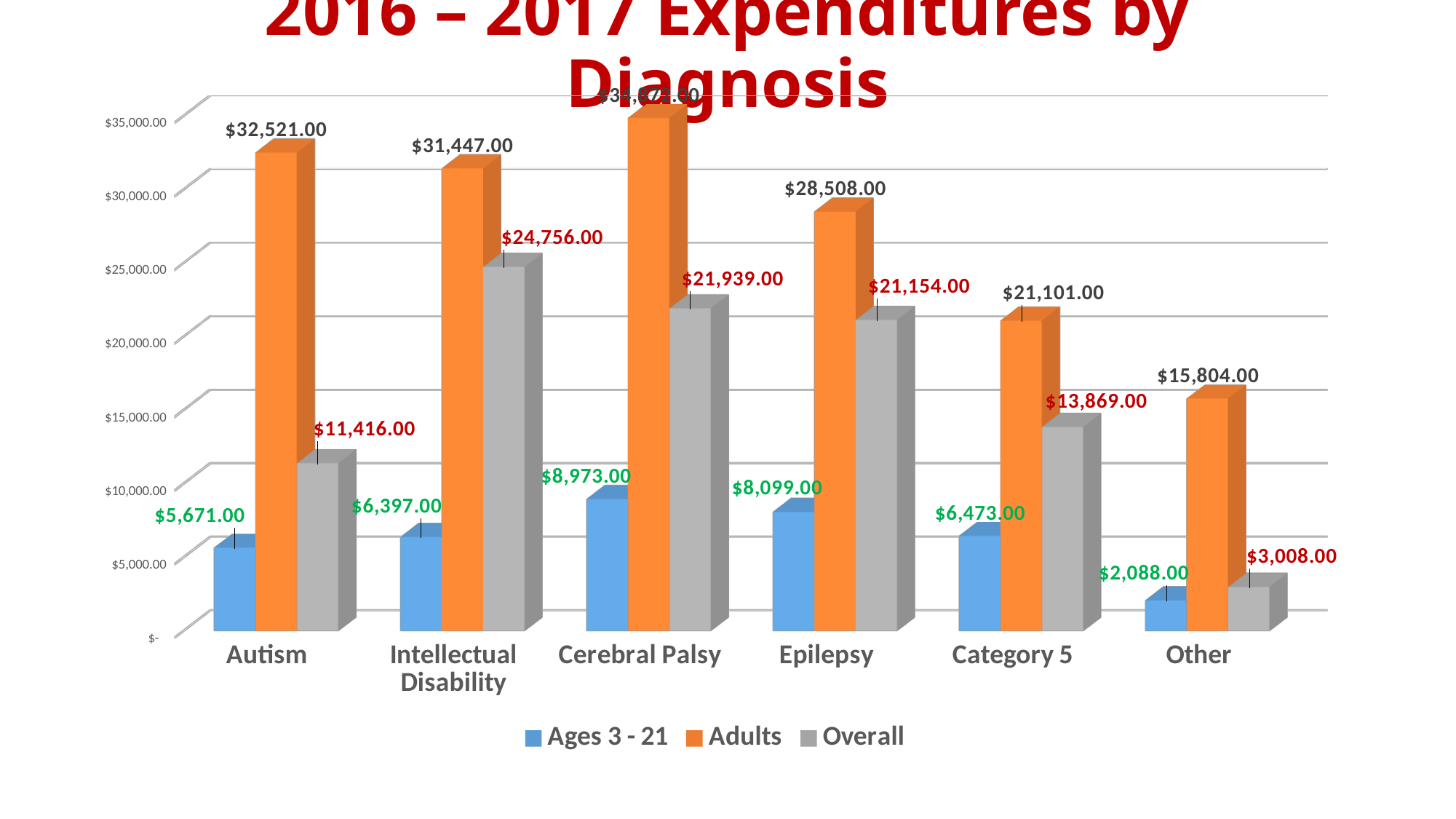
How many series does the legend list? 3 Is the Adults expenditure for Cerebral Palsy greater or less than $30,000.00? greater What is the title of the chart? 2016 – 2017 Expenditures by Diagnosis What is the Ages 3 - 21 expenditure for Cerebral Palsy? $8,973.00 What is the Adults expenditure for Autism? $32,521.00 What is the Overall expenditure for Intellectual Disability? $24,756.00 Which diagnosis has the lowest Adults expenditure? Other What kind of chart is shown on the slide? bar chart What is the difference between the Adults expenditure for Autism and the Adults expenditure for Intellectual Disability? $1,074.00 How many diagnosis categories are shown on the x axis? 6 Which is larger: the Overall expenditure for Epilepsy or the Overall expenditure for Category 5? Epilepsy Which diagnosis has the highest Ages 3 - 21 expenditure? Cerebral Palsy